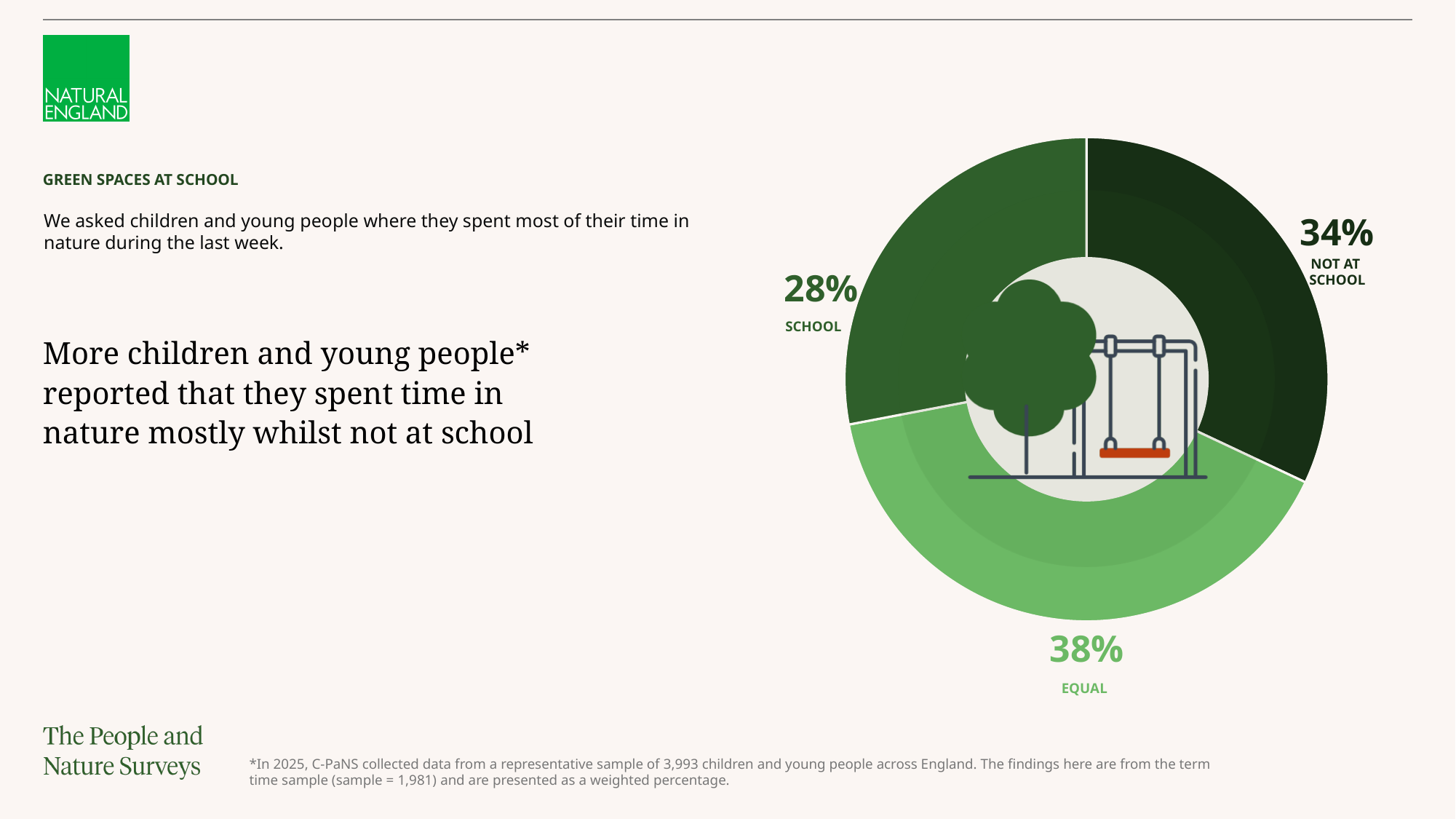
What kind of chart is shown on the slide? Doughnut chart How many categories are shown in the pie chart? 3 What is the combined percentage for 'School' and 'Not at school'? 62% What percentage of children and young people said they spent most of their time in nature while not at school? 34% Which is larger, the share for 'Not at school' or the share for 'School'? Not at school What is the difference in percentage points between the 'Equal' and 'School' categories? 10 Which category has the largest share of the pie chart? Equal What is the difference in percentage points between 'Not at school' and 'School'? 6 What is the heading of the section containing the chart? Green spaces at school Which category has the smallest share of the pie chart? School What percentage of children and young people said they spent an equal amount of time in nature at school and not at school? 38% What percentage of children and young people said they spent most of their time in nature at school? 28%